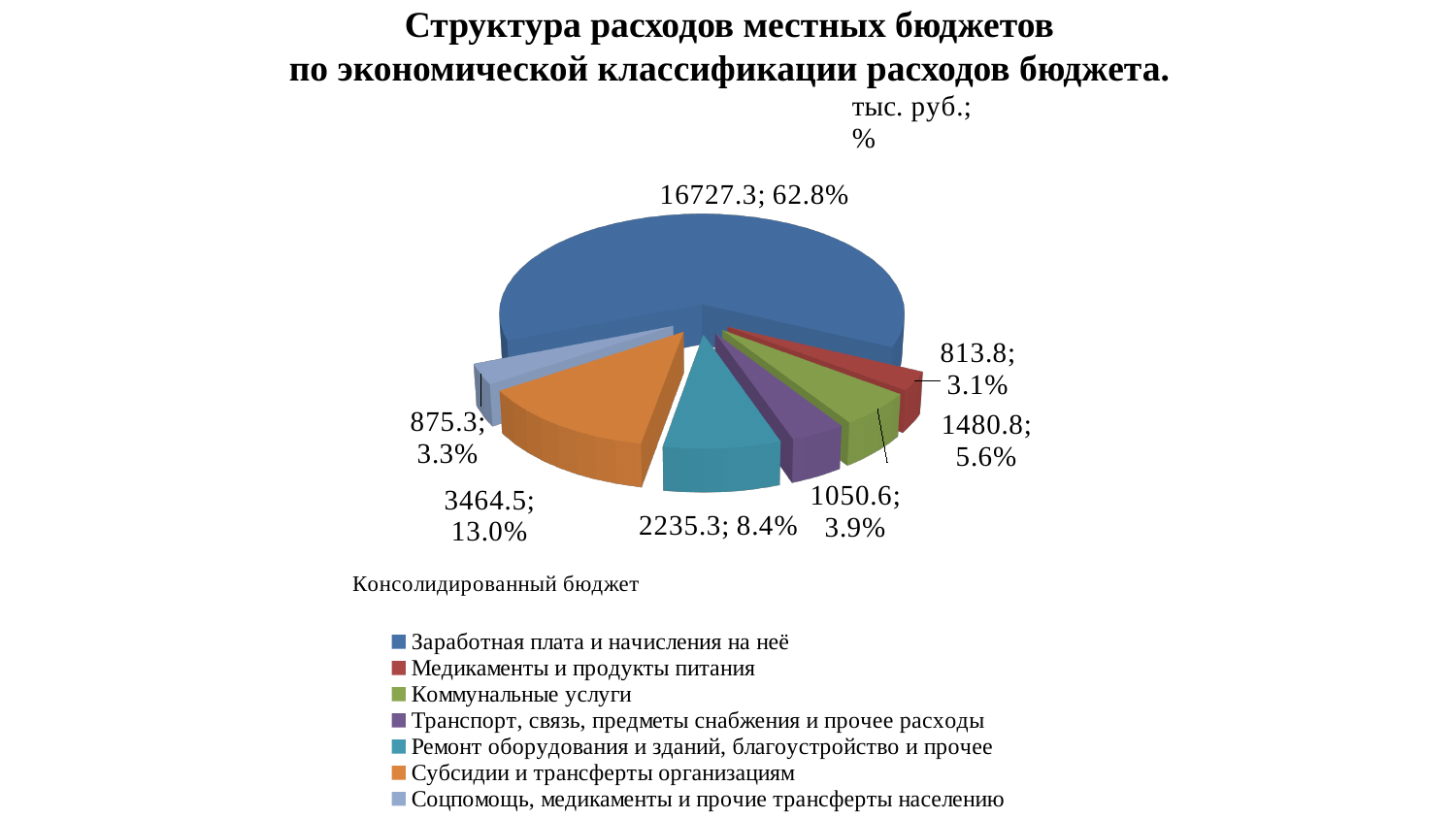
Which category has the smallest share of the pie? Медикаменты и продукты питания What type of chart is shown on the slide? pie chart What percentage is shown for "Ремонт оборудования и зданий, благоустройство и прочее"? 8.4% What value (тыс. руб.) is shown for "Субсидии и трансферты организациям"? 3464.5 What share of the pie does "Заработная плата и начисления на неё" take? 62.8% How many slices does the pie chart have? 7 What value (тыс. руб.) is shown for "Заработная плата и начисления на неё"? 16727.3 What is the difference in тыс. руб. between "Субсидии и трансферты организациям" and "Ремонт оборудования и зданий, благоустройство и прочее"? 1229.2 Which is larger: the value for "Коммунальные услуги" or for "Транспорт, связь, предметы снабжения и прочее расходы"? Коммунальные услуги Which category has the largest share of the pie? Заработная плата и начисления на неё What percentage is shown for "Соцпомощь, медикаменты и прочие трансферты населению"? 3.3% How many entries does the legend list? 7